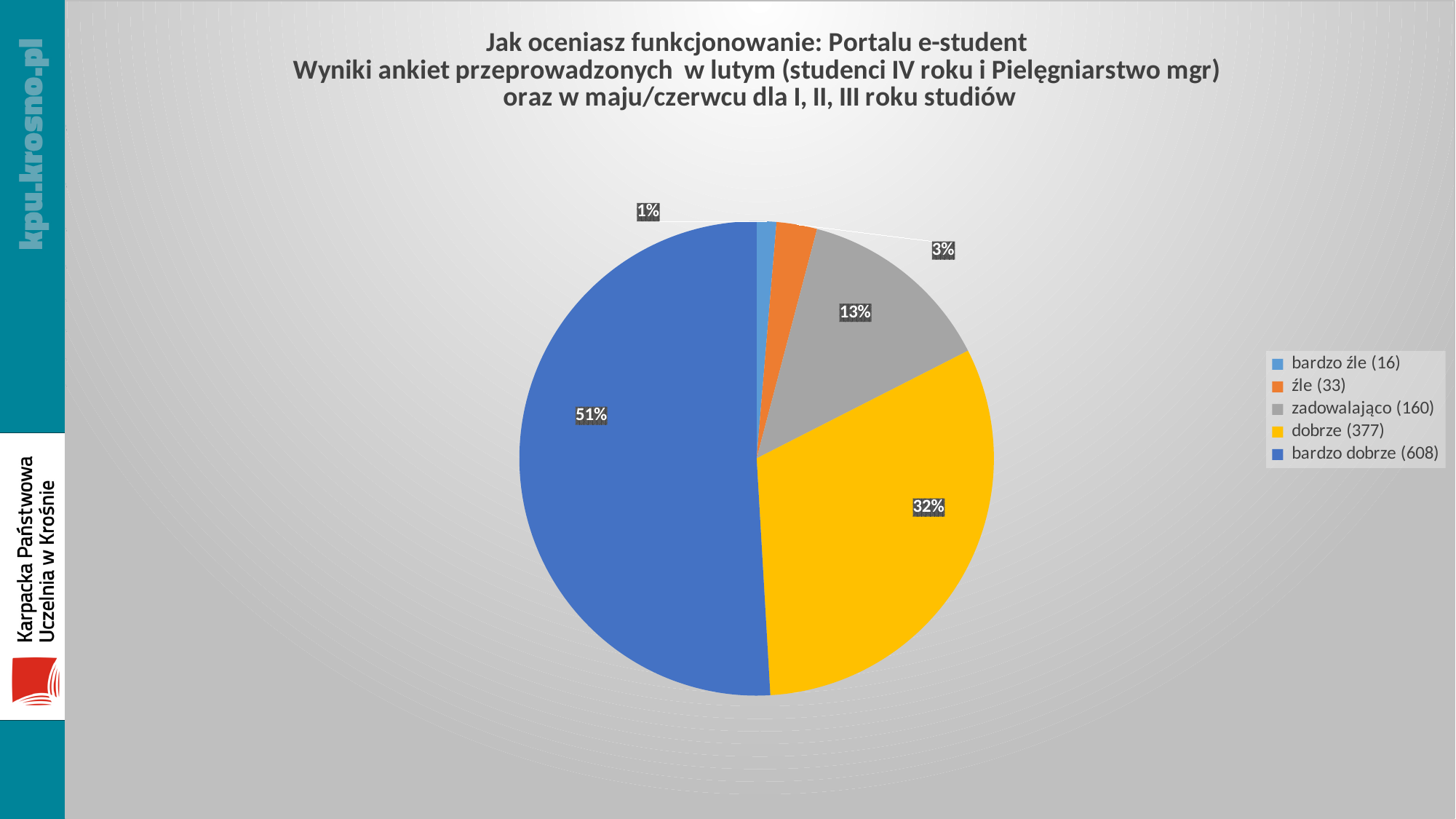
What percentage share does the "źle" slice have? 3% Which category has the smallest slice of the pie? bardzo źle What is the difference in percentage points between the "bardzo dobrze" and "dobrze" slices? 19 What kind of chart is shown on the slide? pie chart Which category has the largest slice of the pie? bardzo dobrze What percentage share does the "bardzo źle" slice have? 1% What percentage share does the "bardzo dobrze" slice have? 51% Which slice is larger, "zadowalająco" or "źle"? zadowalająco What count is shown in the legend for "dobrze"? 377 How many categories does the pie chart have? 5